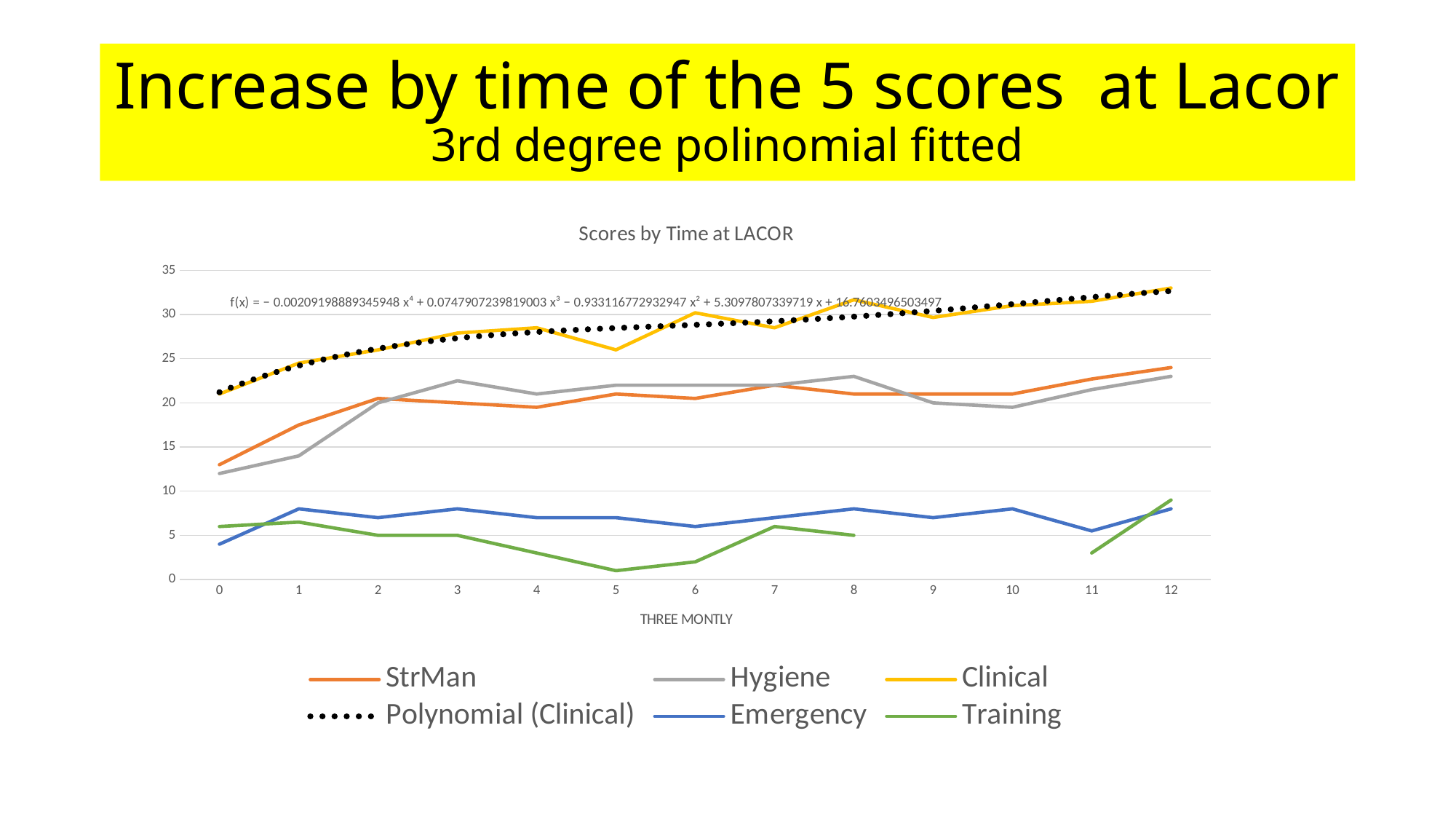
Which series has the highest value at x = 12? Clinical Is the value for Emergency at x = 0 greater or less than 5? less How many series does the legend list? 6 What kind of chart is shown on the slide? line chart Which series is drawn as a dotted line? Polynomial (Clinical) Is the value for Training at x = 5 greater or less than 5? less Does the Clinical series generally rise or fall from x = 0 to x = 12? rise How many points are marked along the x axis (THREE MONTLY)? 13 What is the title of the chart? Scores by Time at LACOR Is the value for Clinical at x = 0 greater or less than 20? greater Which series has the lowest value at x = 5? Training At x = 3, which is larger: Hygiene or StrMan? Hygiene